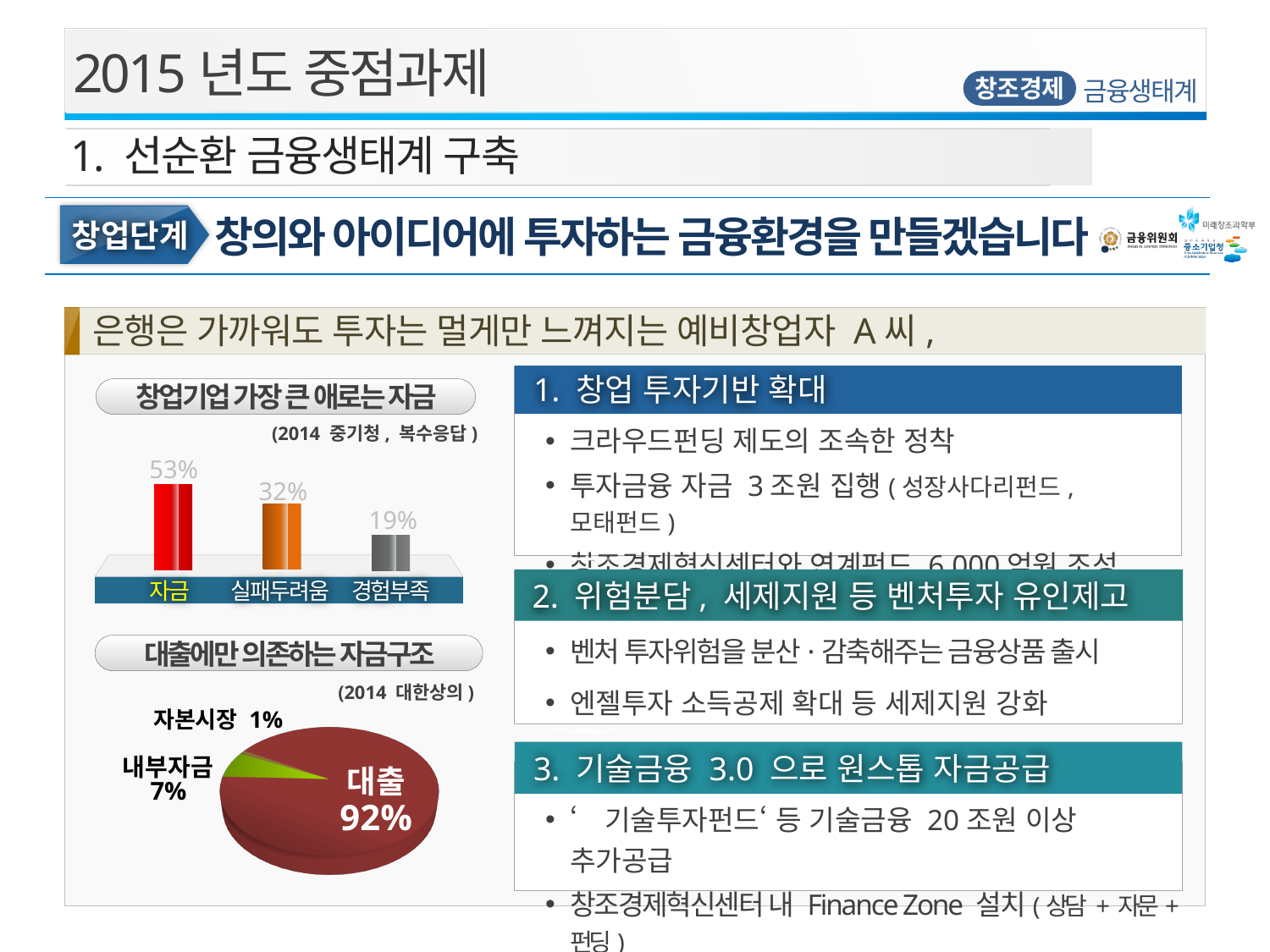
In the bar chart titled '창업기업 가장 큰 애로는 자금', what is the value for 경험부족? 19% What kind of chart is the one titled '대출에만 의존하는 자금구조'? pie chart In the bar chart titled '창업기업 가장 큰 애로는 자금', which category has the lowest value? 경험부족 In the pie chart titled '대출에만 의존하는 자금구조', what is the value for 내부자금? 7% In the pie chart titled '대출에만 의존하는 자금구조', which slice is the smallest? 자본시장 In the bar chart titled '창업기업 가장 큰 애로는 자금', what is the difference between the values for 자금 and 실패두려움? 21% In the bar chart titled '창업기업 가장 큰 애로는 자금', which category has the highest value? 자금 In the bar chart titled '창업기업 가장 큰 애로는 자금', what is the value for 실패두려움? 32% In the bar chart titled '창업기업 가장 큰 애로는 자금', how many categories are shown? 3 What kind of chart is the one titled '창업기업 가장 큰 애로는 자금'? bar chart In the pie chart titled '대출에만 의존하는 자금구조', what share does 대출 have? 92% In the bar chart titled '창업기업 가장 큰 애로는 자금', what is the value for 자금? 53%